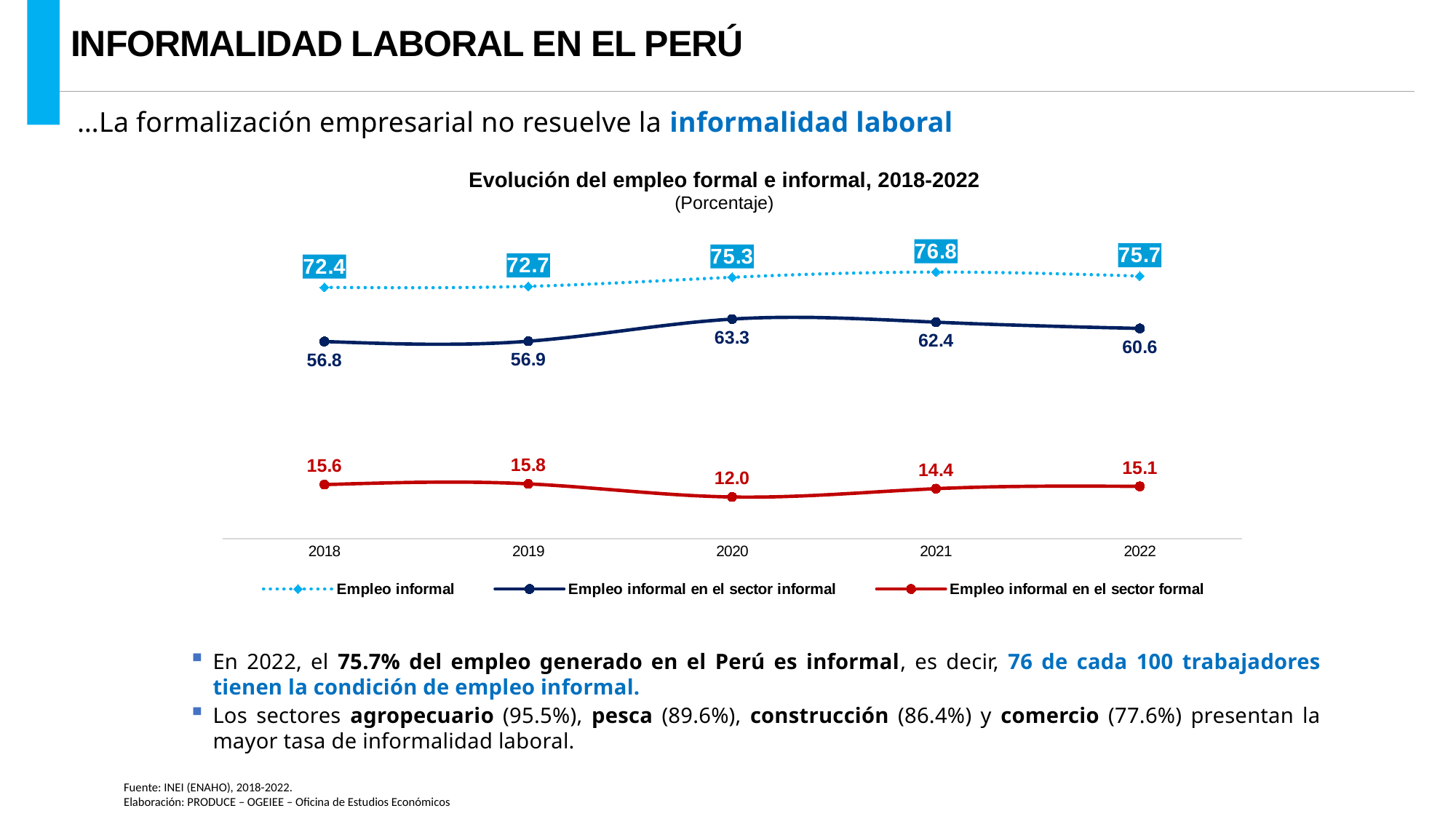
What is the value of Empleo informal en el sector informal in 2020? 63.3 What is the value of Empleo informal in 2022? 75.7 What kind of chart is shown on the slide? Line chart In which year is Empleo informal en el sector formal lowest? 2020 How many series does the legend list? 3 What is the difference between Empleo informal in 2021 and in 2018? 4.4 What is the value of Empleo informal en el sector formal in 2021? 14.4 What is the title of the chart? Evolución del empleo formal e informal, 2018-2022 How many years are shown on the x axis? 5 Which is larger: Empleo informal en el sector informal in 2019 or in 2022? 2022 Does Empleo informal en el sector informal rise or fall from 2020 to 2022? Fall In which year is Empleo informal highest? 2021